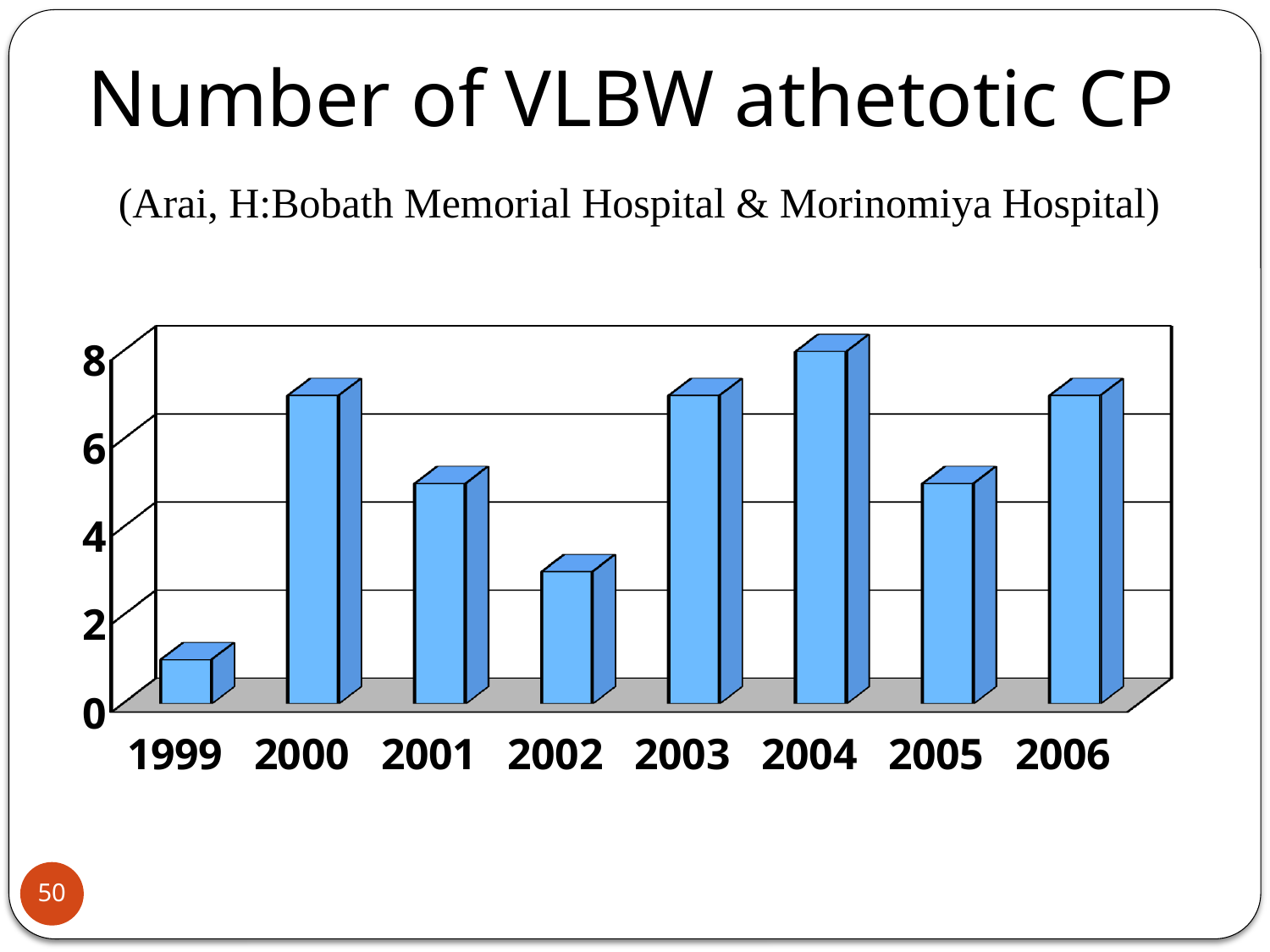
Which year has the highest number of VLBW athetotic CP? 2004 What is the title of the chart on the slide? Number of VLBW athetotic CP How many years are shown on the x axis of the chart? 8 Is the value for 2006 greater or less than 6? greater Is the value for 2005 greater or less than 6? less Which year has the larger value, 2002 or 2003? 2003 Is the value for 2001 greater or less than 4? greater What kind of chart is shown on the slide? bar chart Which year has the lowest number of VLBW athetotic CP? 1999 Which year has the larger value, 2000 or 2001? 2000